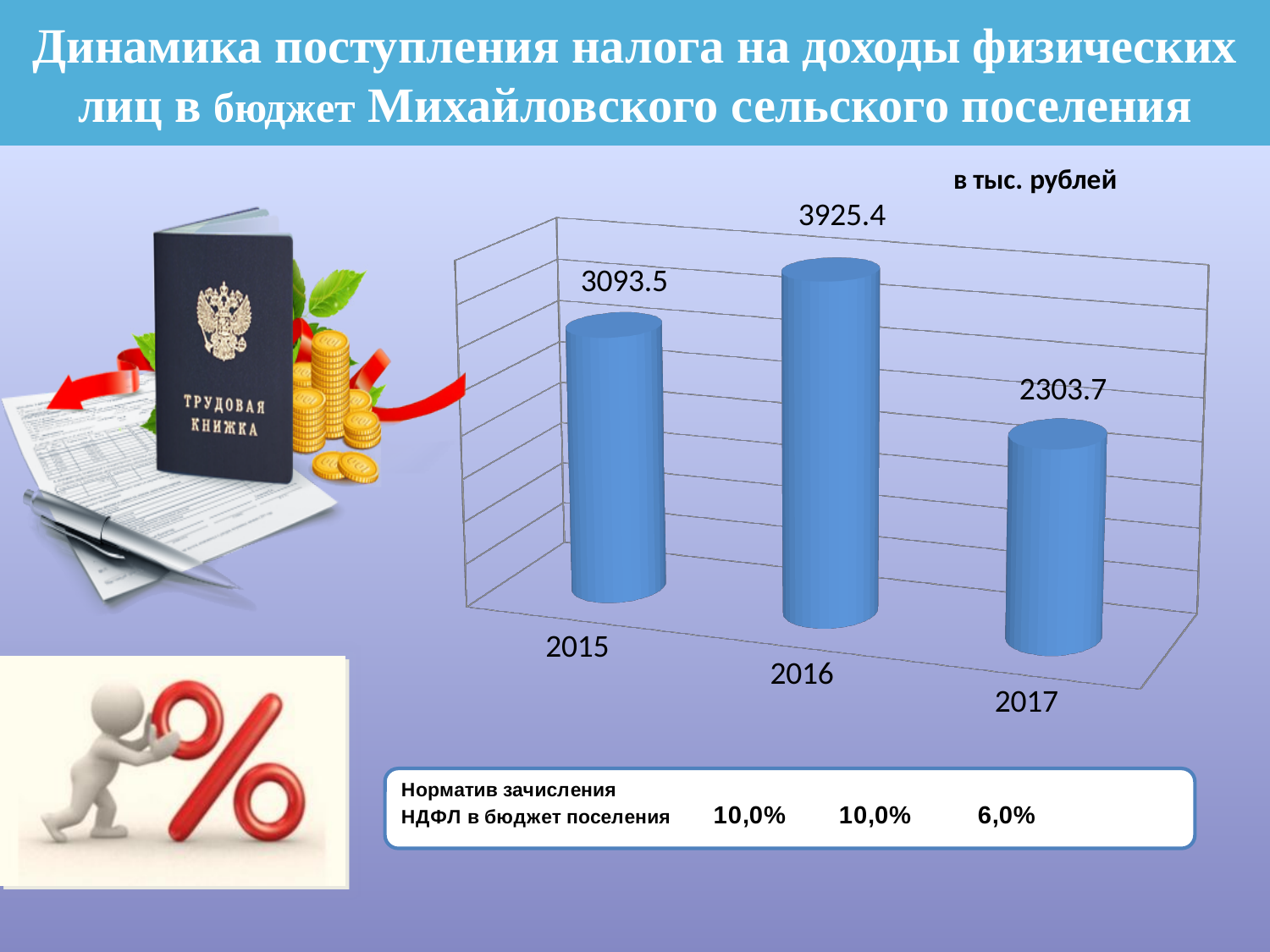
How many years are shown in the chart? 3 Which year has the lowest value? 2017 Which year has the highest value? 2016 Which is larger, the value for 2015 or the value for 2017? 2015 In what units are the chart values given? в тыс. рублей What is the difference between the values for 2015 and 2017? 789.8 What kind of chart is shown on the slide? bar chart What is the difference between the values for 2016 and 2017? 1621.7 What is the value for 2015? 3093.5 What is the value for 2016? 3925.4 What is the value for 2017? 2303.7 What is the difference between the values for 2016 and 2015? 831.9